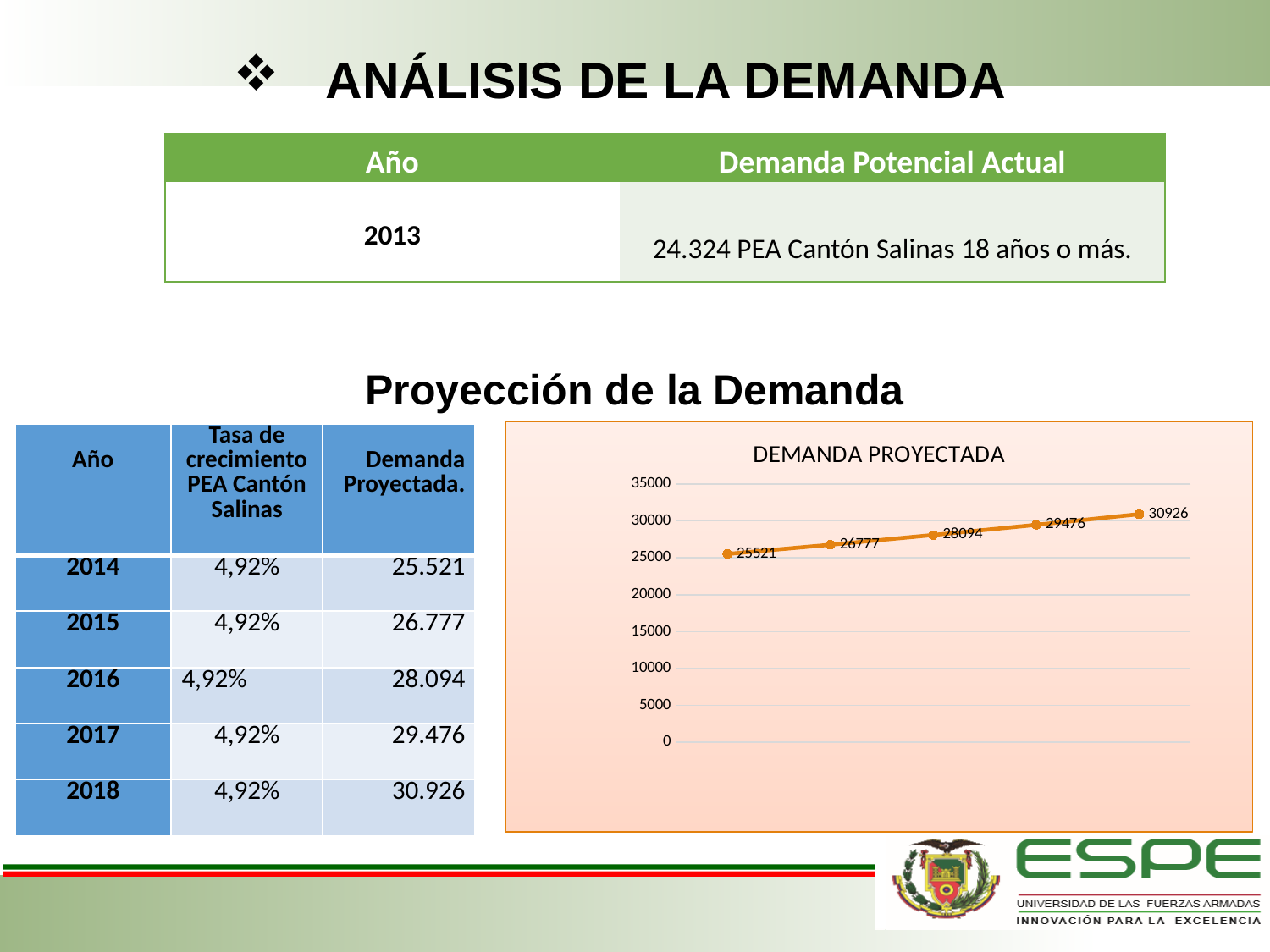
What kind of chart is the DEMANDA PROYECTADA chart? line chart What is the value of the first (leftmost) point on the DEMANDA PROYECTADA chart? 25521 Do the values on the DEMANDA PROYECTADA chart rise or fall from left to right? rise On the DEMANDA PROYECTADA chart, is the value of the last point greater or less than 30000? greater What is the lowest value shown on the DEMANDA PROYECTADA chart? 25521 On the DEMANDA PROYECTADA chart, what is the difference between the second point (26777) and the first point (25521)? 1256 What is the title of the chart on the slide? DEMANDA PROYECTADA What is the highest value shown on the DEMANDA PROYECTADA chart? 30926 How many data points are plotted on the DEMANDA PROYECTADA chart? 5 What is the value of the last (rightmost) point on the DEMANDA PROYECTADA chart? 30926 What is the value of the middle (third) point on the DEMANDA PROYECTADA chart? 28094 On the DEMANDA PROYECTADA chart, what is the difference between the last point (30926) and the first point (25521)? 5405